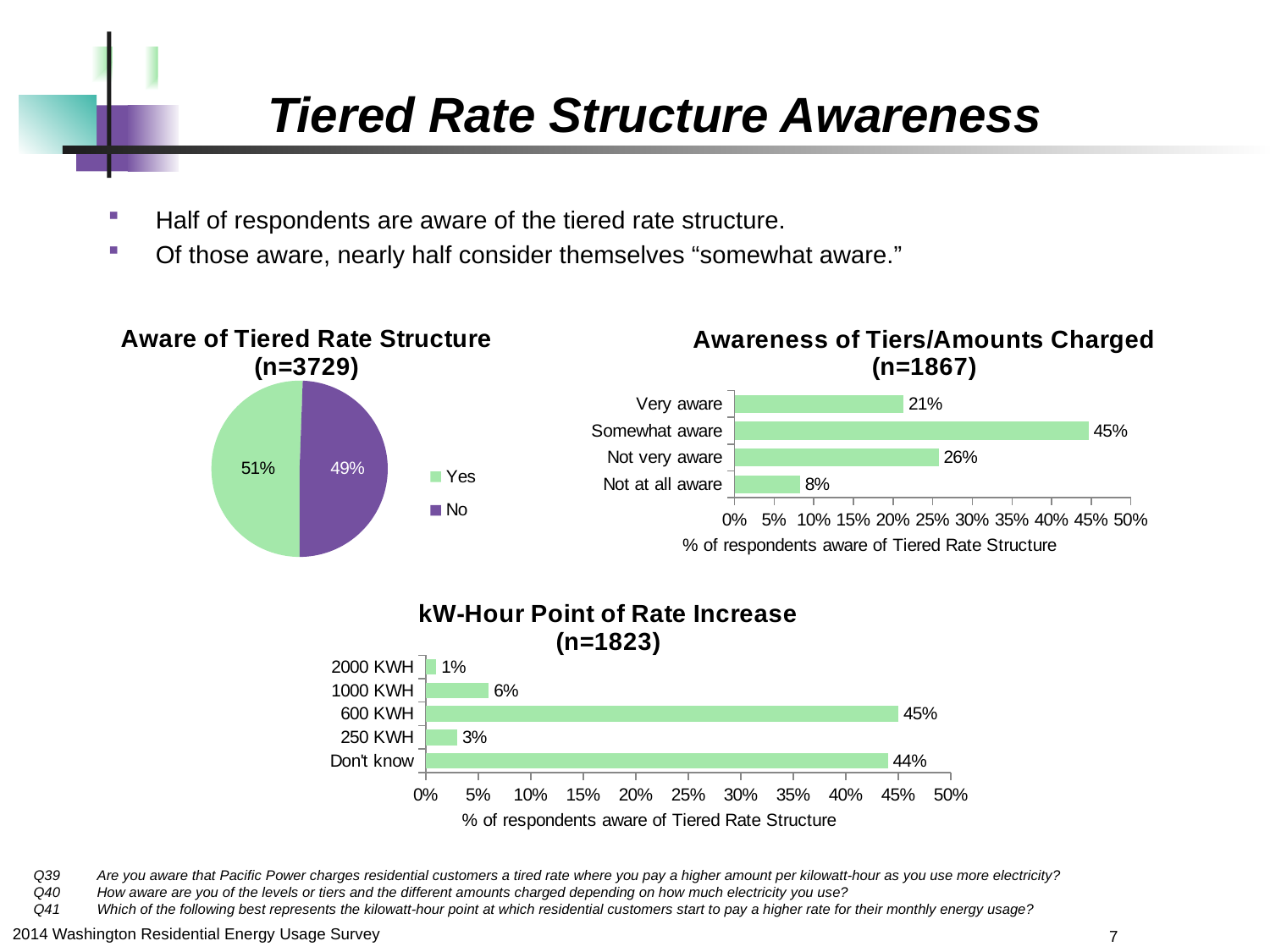
In the 'kW-Hour Point of Rate Increase' chart, what is the value for 600 KWH? 45% What kind of chart is 'kW-Hour Point of Rate Increase'? Bar chart In the 'Awareness of Tiers/Amounts Charged' chart, how many categories are shown? 4 In the 'kW-Hour Point of Rate Increase' chart, which is larger, 1000 KWH or 250 KWH? 1000 KWH In the 'Awareness of Tiers/Amounts Charged' chart, which category has the lowest value? Not at all aware In the 'Awareness of Tiers/Amounts Charged' chart, what is the difference between Not very aware and Very aware? 5% What kind of chart is 'Aware of Tiered Rate Structure'? Pie chart In the 'kW-Hour Point of Rate Increase' chart, what is the difference between 600 KWH and Don't know? 1% In the 'Awareness of Tiers/Amounts Charged' chart, what is the value for Somewhat aware? 45% In the 'kW-Hour Point of Rate Increase' chart, which category has the lowest value? 2000 KWH In the 'Aware of Tiered Rate Structure' pie chart, what percentage of respondents answered No? 49% In the 'Aware of Tiered Rate Structure' pie chart, what percentage of respondents answered Yes? 51%